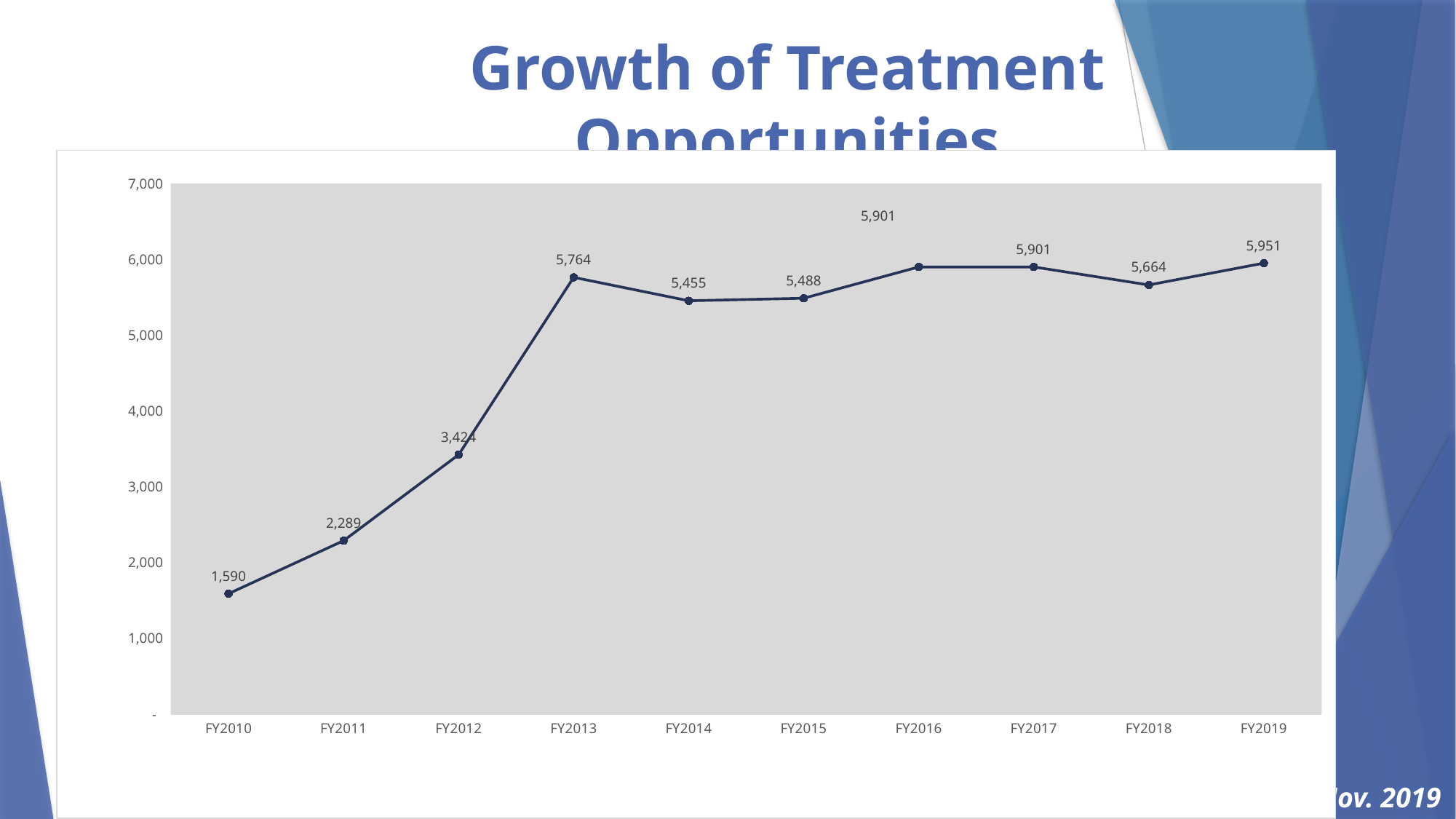
Which fiscal year has the highest value? FY2019 Which is larger, the value for FY2014 or the value for FY2015? FY2015 What is the value for FY2013? 5,764 Do the values rise or fall from FY2010 to FY2013? rise Is the value for FY2012 greater or less than 3,000? greater What is the difference between the values for FY2013 and FY2012? 2,340 Which fiscal year has the lowest value? FY2010 What is the value for FY2018? 5,664 What is the value for FY2010? 1,590 What is the value for FY2019? 5,951 What kind of chart is shown on the slide? line chart How many fiscal years are plotted on the x axis? 10